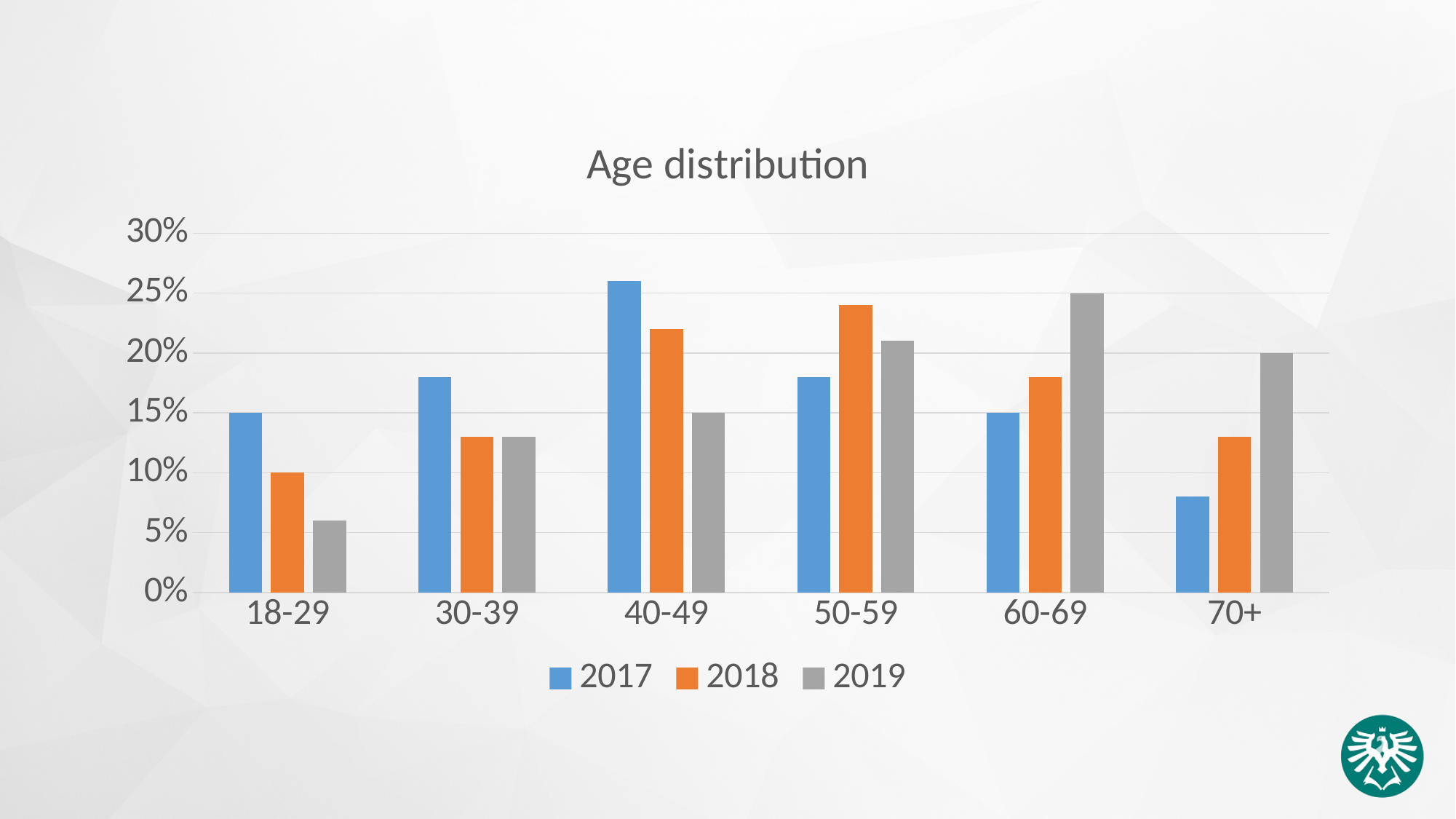
Is the 2019 value for 18-29 greater or less than 10%? less How many series does the legend list? 3 How many age groups are shown on the x axis? 6 Is the 2018 value for 50-59 greater or less than 20%? greater For the 18-29 age group, which is larger: the 2017 value or the 2019 value? 2017 Which age group has the lowest value for 2019? 18-29 What is the 2019 value for the 60-69 age group? 25% Which age group has the highest value for 2017? 40-49 Is the 2017 value for 40-49 greater or less than 25%? greater What kind of chart is shown on the slide? bar chart What is the title of the chart? Age distribution Which age group has the highest value for 2019? 60-69